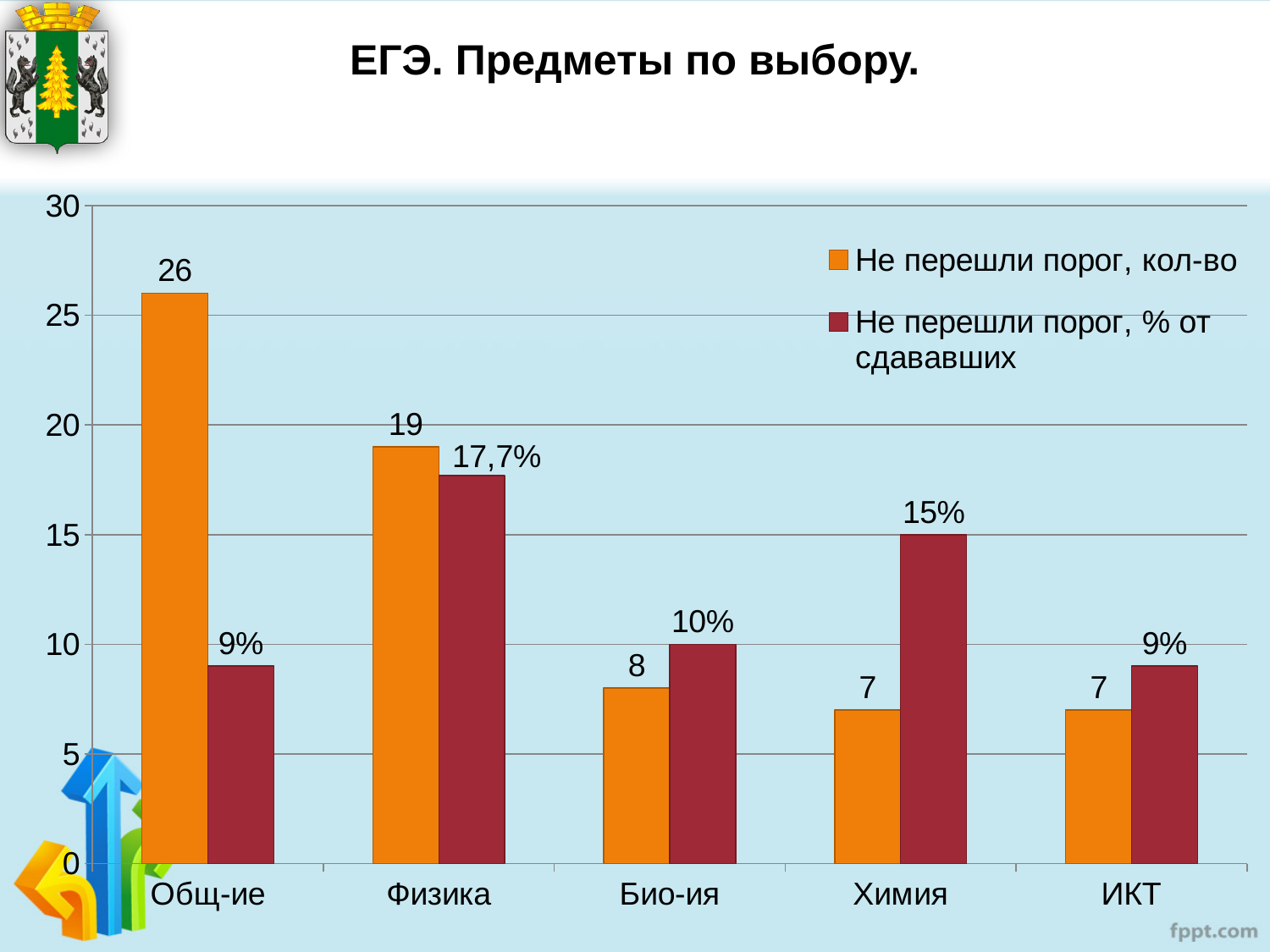
What is the value of "Не перешли порог, кол-во" for Био-ия? 8 What is the value of "Не перешли порог, % от сдававших" for Физика? 17,7% What is the value of "Не перешли порог, кол-во" for Общ-ие? 26 Which category has the lowest value for "Не перешли порог, % от сдававших"? Общ-ие and ИКТ (both 9%) What is the difference between the "Не перешли порог, кол-во" values for Общ-ие and Физика? 7 What kind of chart is shown on the slide? Bar chart Which category has the highest value for "Не перешли порог, кол-во"? Общ-ие What is the value of "Не перешли порог, % от сдававших" for Химия? 15% Which is larger: the "Не перешли порог, % от сдававших" value for Химия or for Био-ия? Химия How many series does the legend list? 2 Which category has the highest value for "Не перешли порог, % от сдававших"? Физика How many categories are shown on the x axis? 5